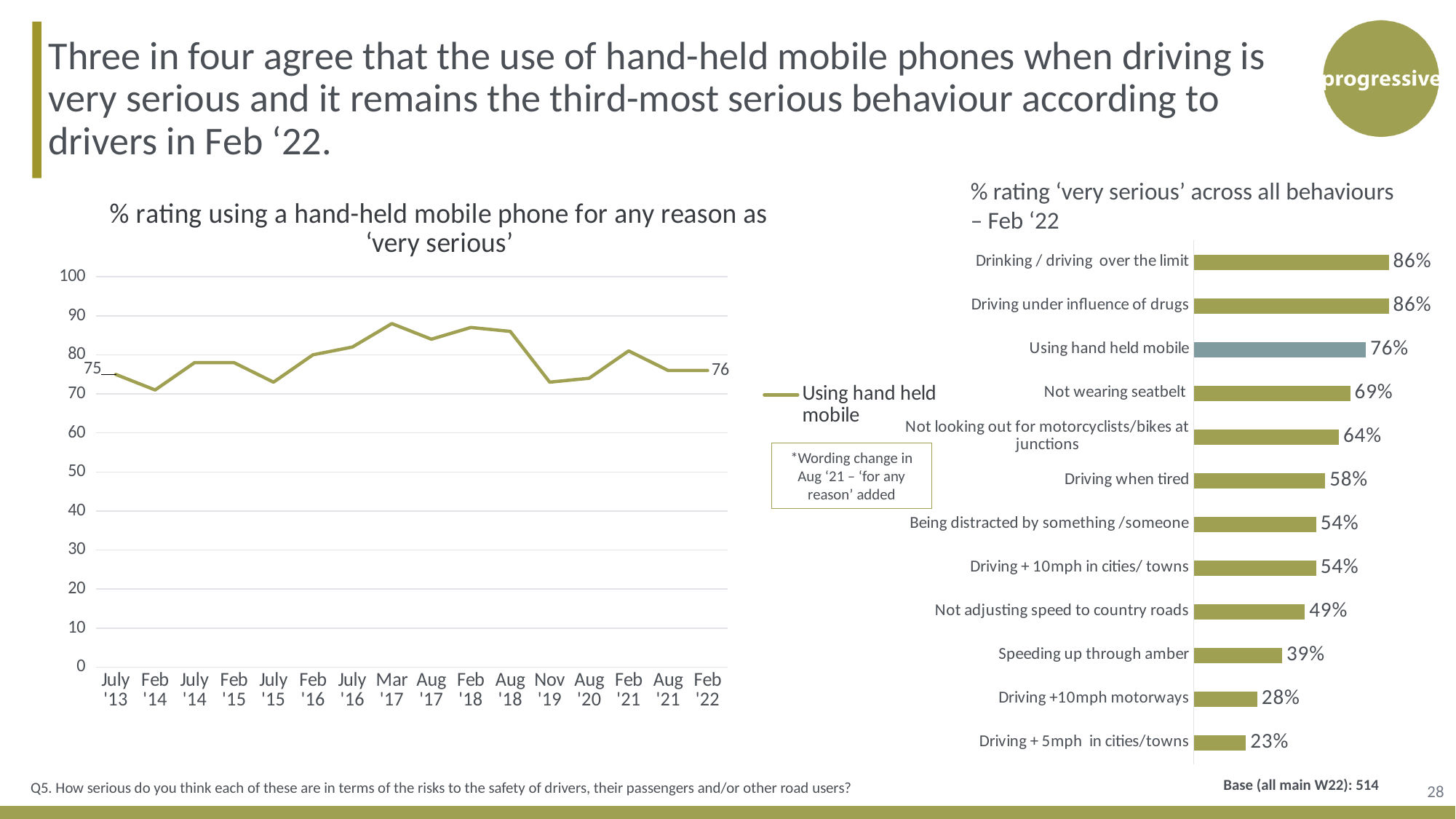
In the right chart, '% rating very serious across all behaviours – Feb '22', what is the value for Not wearing seatbelt? 69% What kind of chart is the left chart, '% rating using a hand-held mobile phone for any reason as very serious'? Line chart In the right chart, '% rating very serious across all behaviours – Feb '22', how many behaviours are listed? 12 In the left chart, '% rating using a hand-held mobile phone for any reason as very serious', what value is shown for Feb '22? 76 In the right chart, '% rating very serious across all behaviours – Feb '22', what is the difference between Drinking / driving over the limit and Using hand held mobile? 10 percentage points In the right chart, '% rating very serious across all behaviours – Feb '22', which behaviour has the lowest value? Driving + 5mph in cities/towns In the right chart, '% rating very serious across all behaviours – Feb '22', what is the value for Speeding up through amber? 39% In the right chart, '% rating very serious across all behaviours – Feb '22', which is larger: Driving when tired or Not adjusting speed to country roads? Driving when tired In the left chart, '% rating using a hand-held mobile phone for any reason as very serious', is the value for Mar '17 greater or less than 80? greater In the left chart, '% rating using a hand-held mobile phone for any reason as very serious', what value is shown for July '13? 75 In the left chart, '% rating using a hand-held mobile phone for any reason as very serious', is the value for Feb '14 greater or less than 80? less In the left chart, '% rating using a hand-held mobile phone for any reason as very serious', how many time points are plotted on the x axis? 16